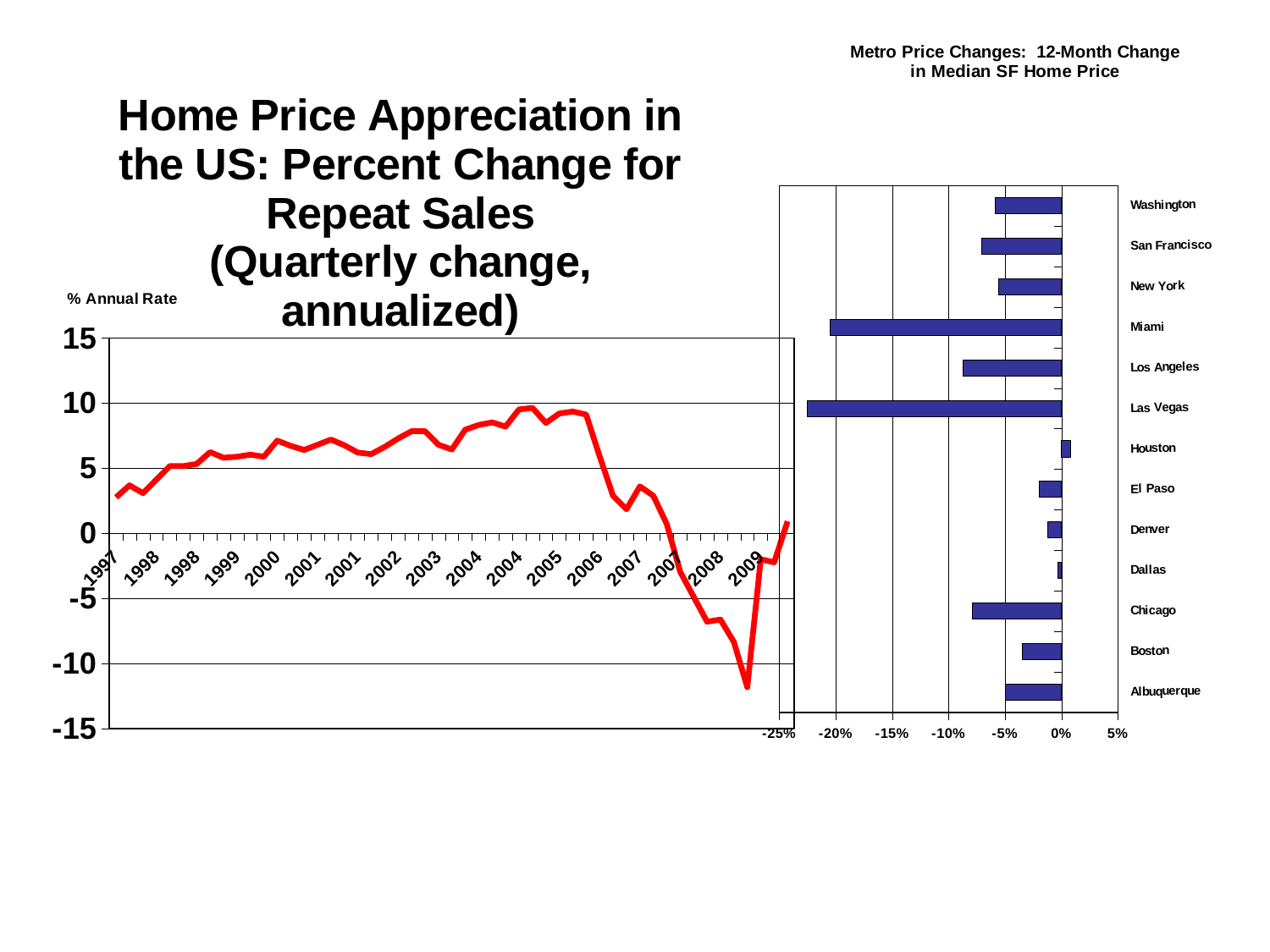
In the Metro Price Changes chart, which metro area has the lowest (most negative) value? Las Vegas In the Home Price Appreciation line chart, is the lowest point on the line greater or less than -10? less In the Metro Price Changes chart, is the value for Las Vegas greater or less than -20%? less In the Metro Price Changes chart, is the value for Washington greater or less than -10%? greater What kind of chart is the chart titled "Home Price Appreciation in the US"? line chart What is the y-axis label of the Home Price Appreciation line chart? % Annual Rate In the Metro Price Changes chart, how many metro areas are shown? 13 In the Metro Price Changes chart, which metro area has the highest value? Houston In the Home Price Appreciation line chart, do the values rise or fall between 2006 and 2008? fall What kind of chart is the chart titled "Metro Price Changes: 12-Month Change in Median SF Home Price"? bar chart In the Metro Price Changes chart, which has the larger value, Miami or New York? New York